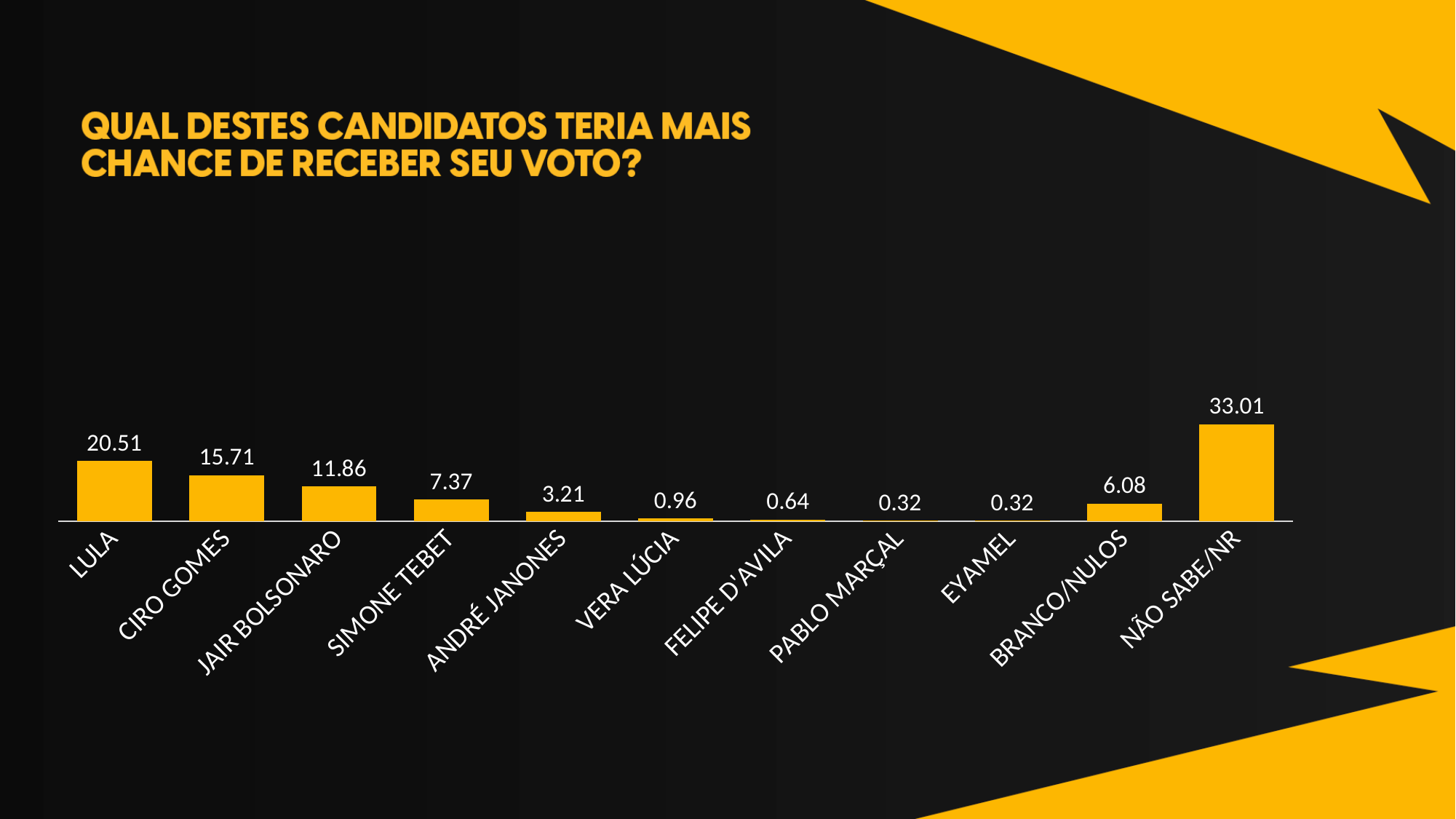
What is the value for CIRO GOMES? 15.71 What is the value for LULA? 20.51 Which category has the highest value? NÃO SABE/NR Which candidate has the highest value among the named candidates? LULA What is the value for BRANCO/NULOS? 6.08 What kind of chart is shown on the slide? Bar chart Which two categories share the same value of 0.32? PABLO MARÇAL and EYAMEL How many categories are shown on the x axis? 11 What is the difference between the values for NÃO SABE/NR and LULA? 12.50 What is the title of the slide? QUAL DESTES CANDIDATOS TERIA MAIS CHANCE DE RECEBER SEU VOTO? What is the difference between the values for LULA and CIRO GOMES? 4.80 Which is larger, the value for JAIR BOLSONARO or the value for SIMONE TEBET? JAIR BOLSONARO